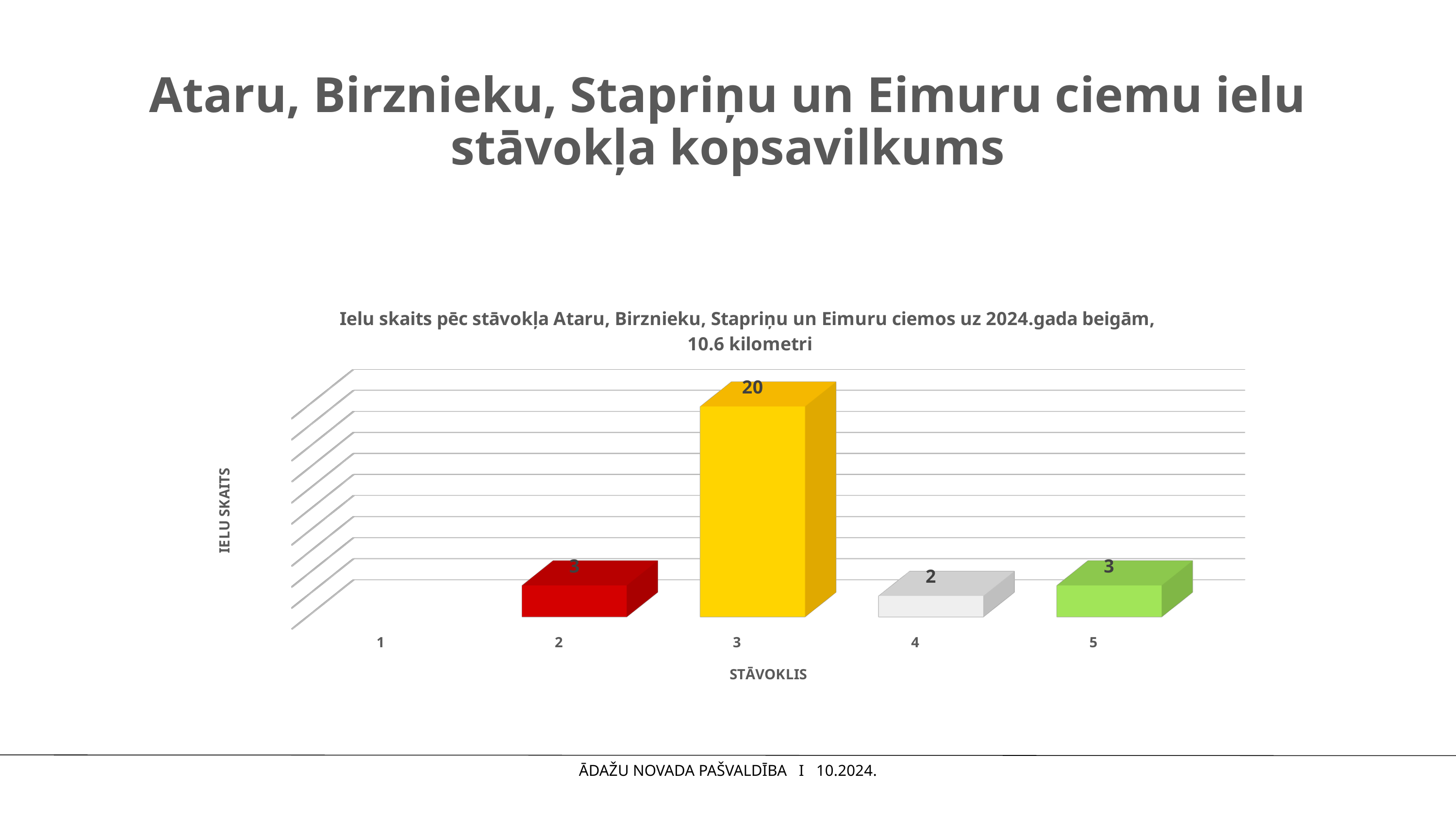
What is the value for category 3 on the x axis? 20 Which category has the highest value? 3 What is the value for category 2 on the x axis? 3 What is the difference between the values for category 3 and category 2? 17 What is the value for category 4 on the x axis? 2 What is the difference between the values for category 5 and category 4? 1 What is the label of the x axis? STĀVOKLIS What is the label of the y axis? IELU SKAITS How many categories are labelled on the x axis? 5 What type of chart is shown on the slide? Bar chart What is the value for category 5 on the x axis? 3 Which is larger, the value for category 2 or the value for category 4? Category 2